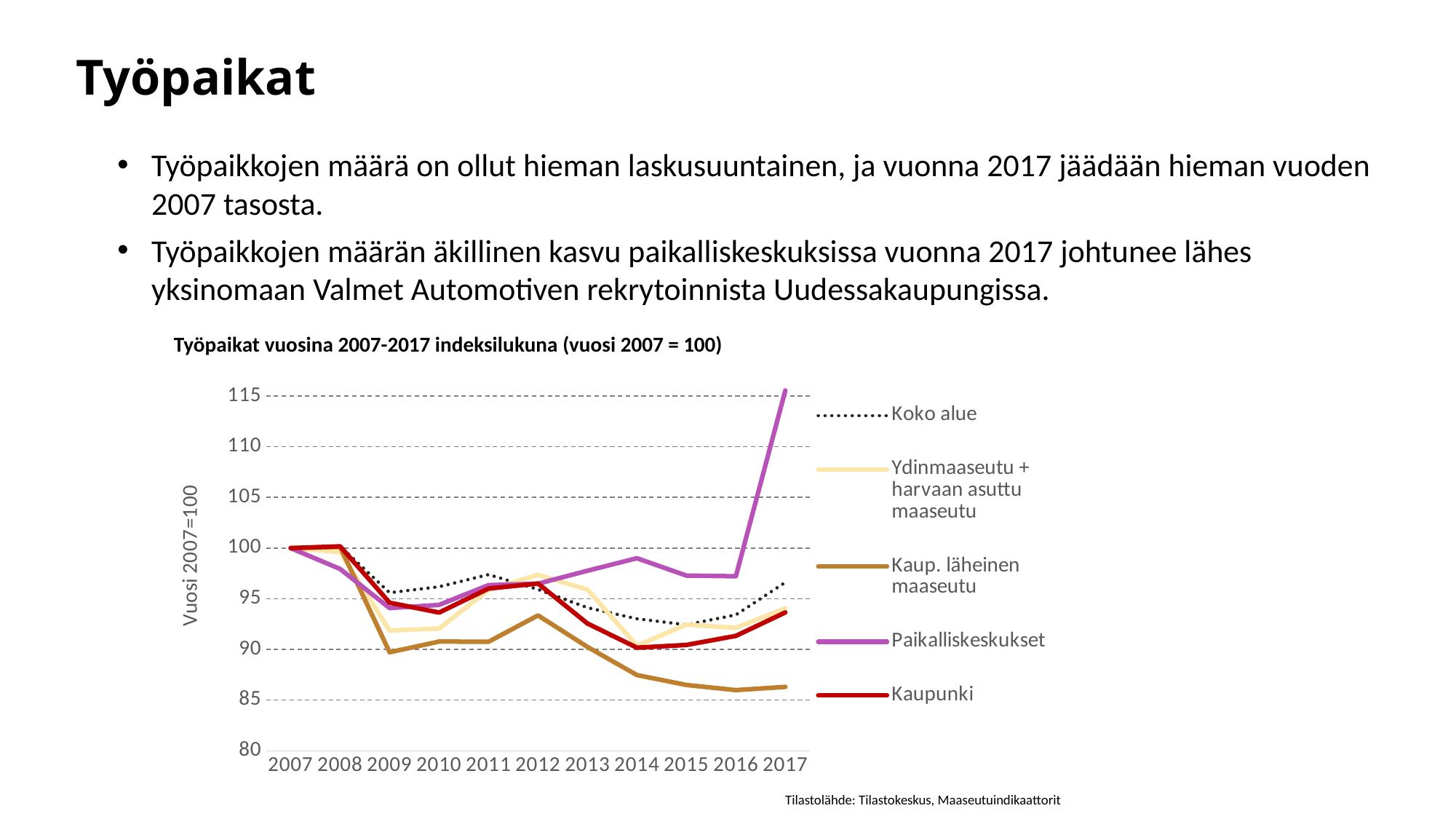
Is the value for Koko alue in 2015 greater or less than 95? less Is the value for Paikalliskeskukset in 2017 greater or less than 110? greater In 2014, which is larger: the value for Paikalliskeskukset or the value for Kaupunki? Paikalliskeskukset How many series does the legend list? 5 What is the index value for Kaupunki in 2007? 100 Which series has the lowest value in 2017? Kaup. läheinen maaseutu Does the Kaup. läheinen maaseutu line rise or fall from 2012 to 2016? fall Is the value for Kaup. läheinen maaseutu in 2016 greater or less than 90? less Which series has the highest value in 2017? Paikalliskeskukset How many years are plotted along the x axis? 11 What is the title of the chart? Työpaikat vuosina 2007-2017 indeksilukuna (vuosi 2007 = 100) What kind of chart is shown on the slide? line chart